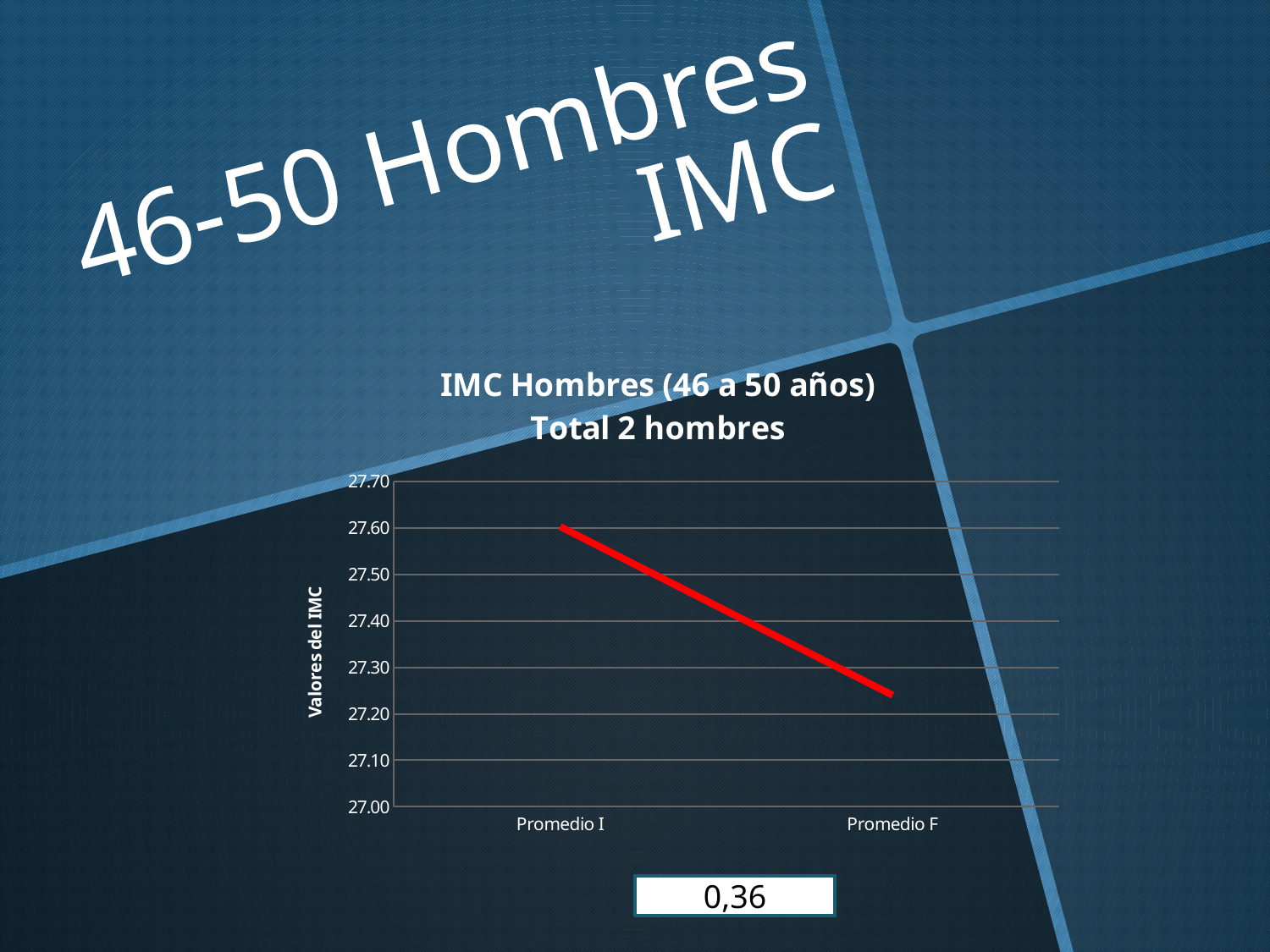
What is the title of the chart? IMC Hombres (46 a 50 años) Total 2 hombres Which category has the lowest value in the chart? Promedio F Is the value for Promedio F greater or less than 27.30? less What kind of chart is shown on the slide? line chart Is the value for Promedio I greater or less than 27.50? greater How many categories are shown on the x axis of the chart? 2 Is the value for Promedio F greater or less than 27.20? greater Do the values rise or fall from Promedio I to Promedio F? fall Which category has the highest value in the chart? Promedio I Which category has the higher value, Promedio I or Promedio F? Promedio I What is the label of the vertical axis of the chart? Valores del IMC